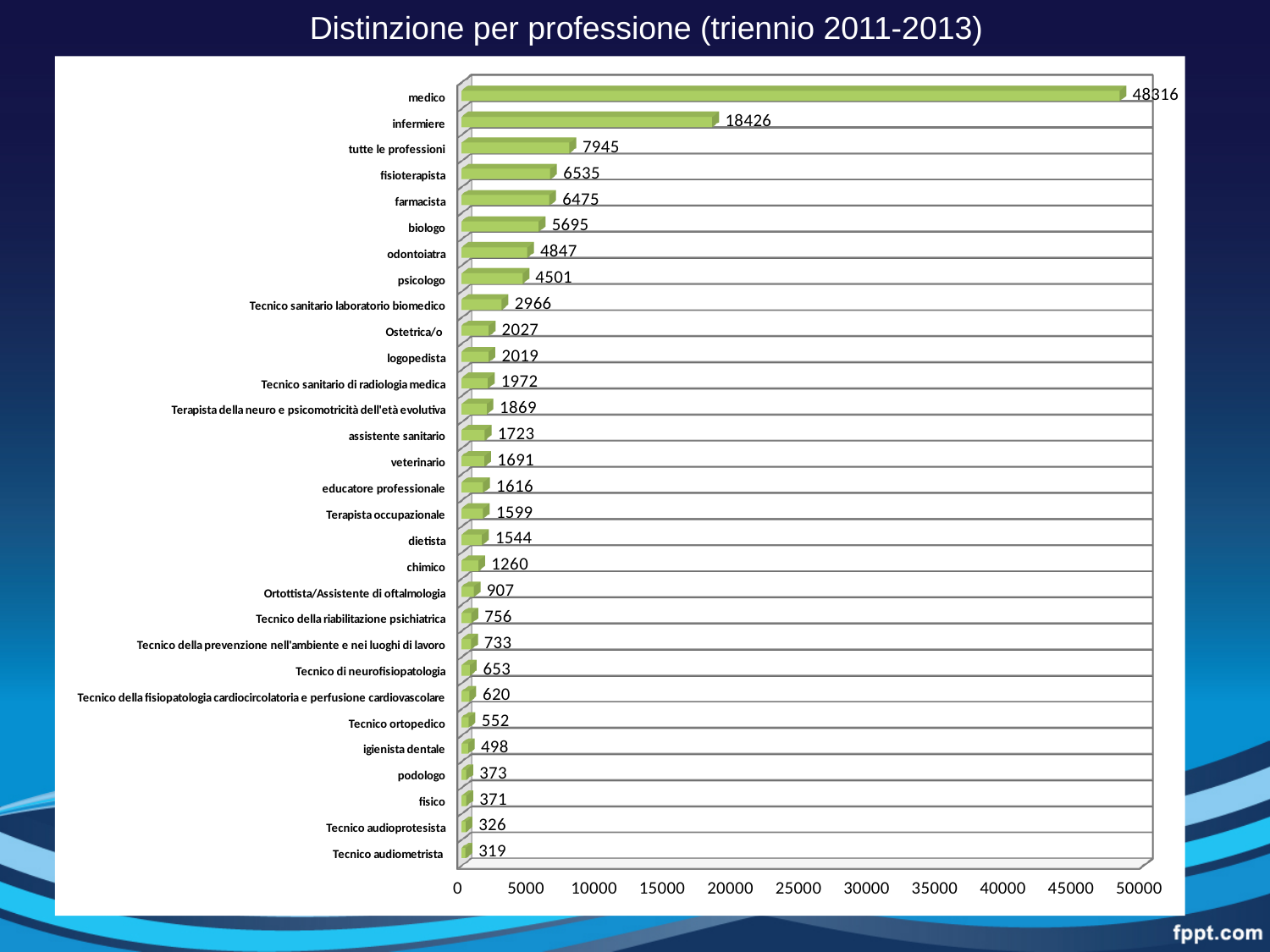
What is the value for infermiere? 18426 What is the value for medico? 48316 Which has a larger value, fisioterapista or farmacista? fisioterapista What is the title of the slide? Distinzione per professione (triennio 2011-2013) What is the value for psicologo? 4501 What kind of chart is shown on the slide? bar chart Which profession has the highest value? medico What is the difference between the values for medico and infermiere? 29890 How many professions are shown in the chart? 30 What is the value for Tecnico audiometrista? 319 Is the value for tutte le professioni greater or less than 10000? less Which profession has the lowest value? Tecnico audiometrista